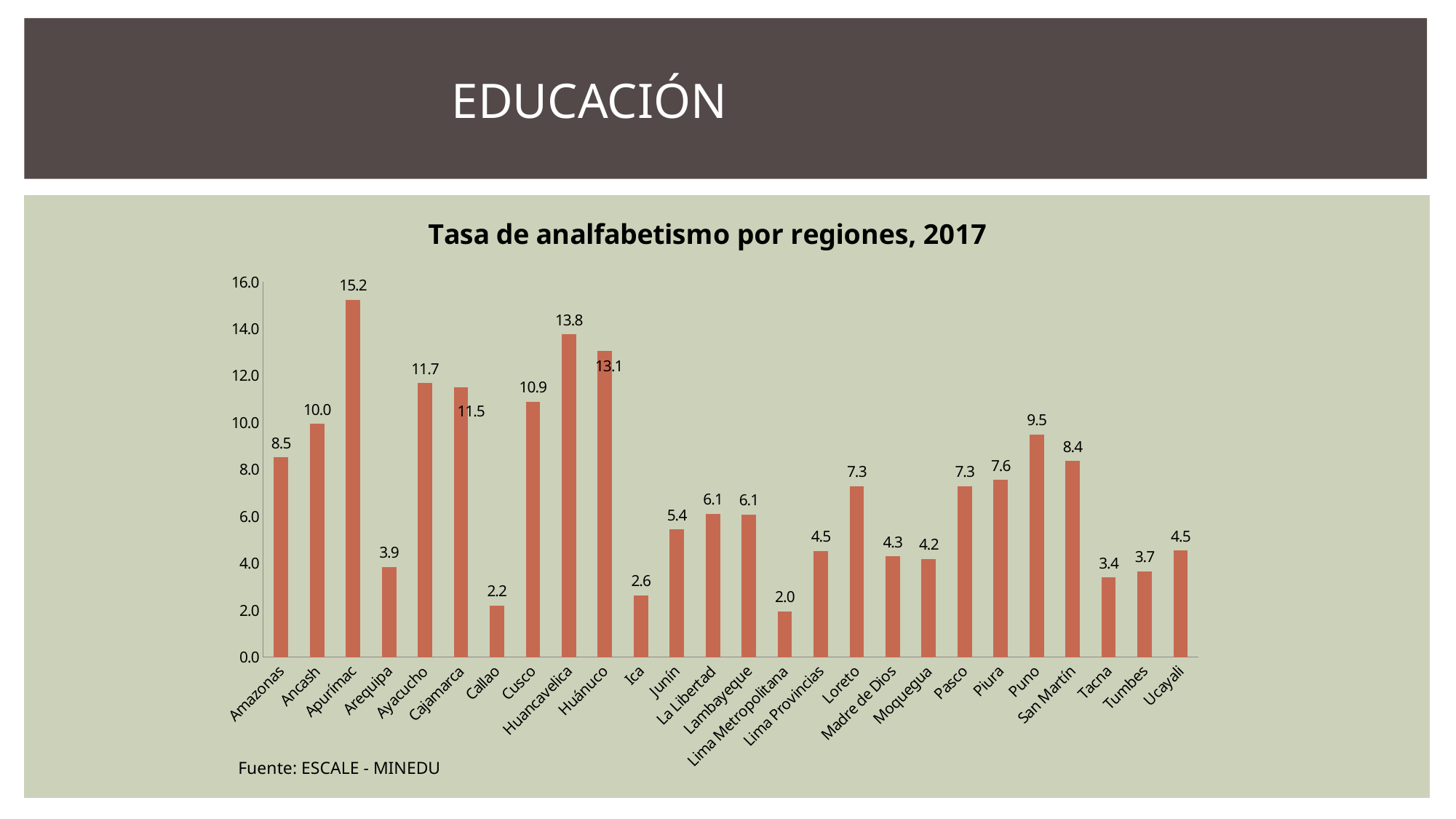
Which region has the highest value? Apurímac How many regions are shown on the chart? 26 What is the title of the chart? Tasa de analfabetismo por regiones, 2017 Is the value for Loreto greater or less than 6.0? greater What is the value for Huancavelica? 13.8 What is the value for Apurímac? 15.2 Which region has the lowest value? Lima Metropolitana What is the value for Puno? 9.5 What is the difference between the values for Apurímac and Huánuco? 2.1 Which is larger, the value for Cusco or the value for Ayacucho? Ayacucho What kind of chart is shown? Bar chart What is the value for Lima Metropolitana? 2.0